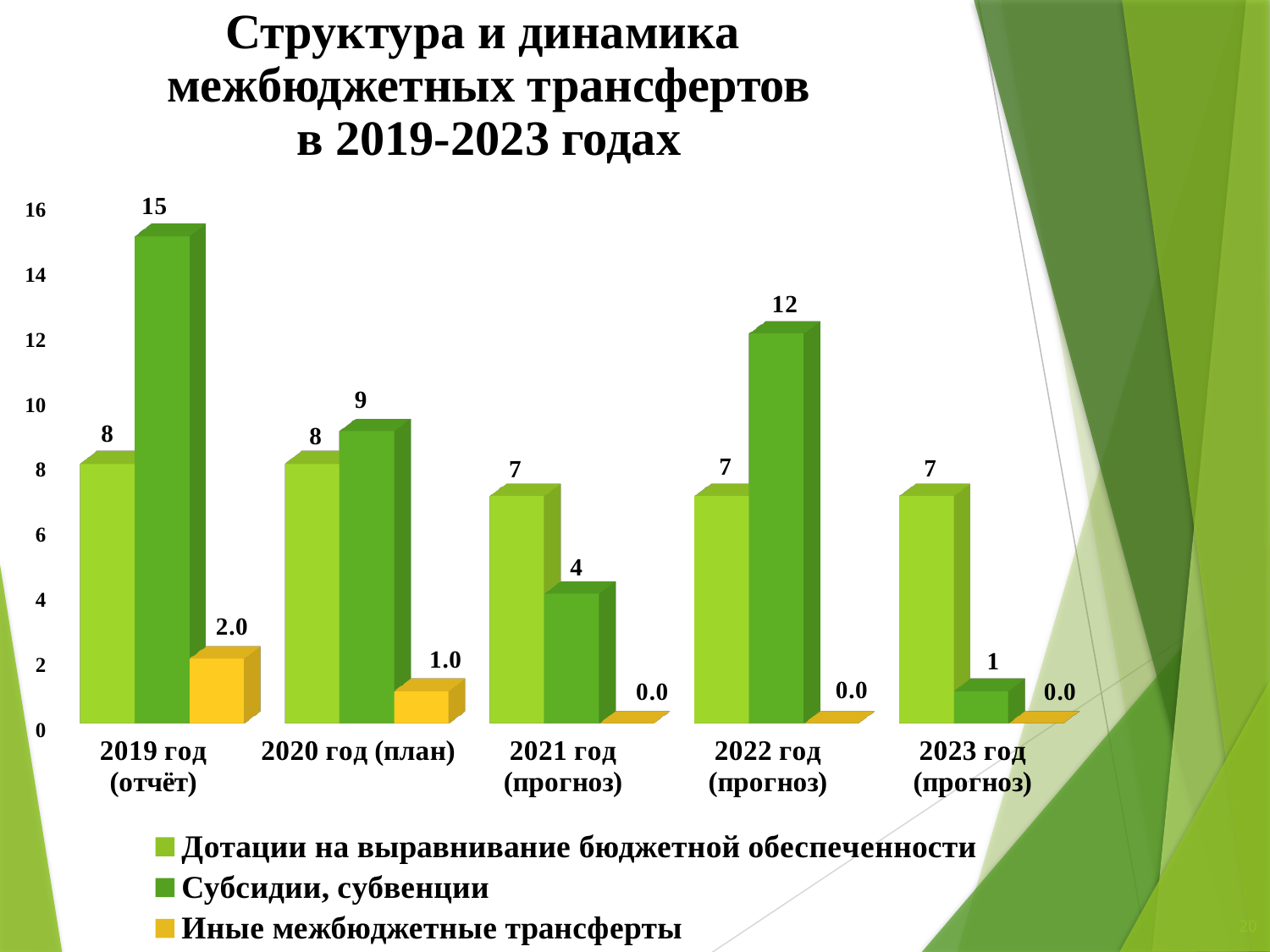
What type of chart is shown on the slide? bar chart What is the value for Субсидии, субвенции in 2019 год (отчёт)? 15 What is the value for Дотации на выравнивание бюджетной обеспеченности in 2023 год (прогноз)? 7 How many year categories are shown on the x axis? 5 What is the total of the three series for 2019 год (отчёт)? 25.0 What is the difference between Субсидии, субвенции in 2022 год (прогноз) and in 2021 год (прогноз)? 8 Which is larger in 2020 год (план): Дотации на выравнивание бюджетной обеспеченности or Субсидии, субвенции? Субсидии, субвенции What is the value for Иные межбюджетные трансферты in 2020 год (план)? 1.0 Which colour represents Иные межбюджетные трансферты in the legend? yellow How many series does the legend list? 3 In which year is the value for Субсидии, субвенции the highest? 2019 год (отчёт) In which year is the value for Субсидии, субвенции the lowest? 2023 год (прогноз)